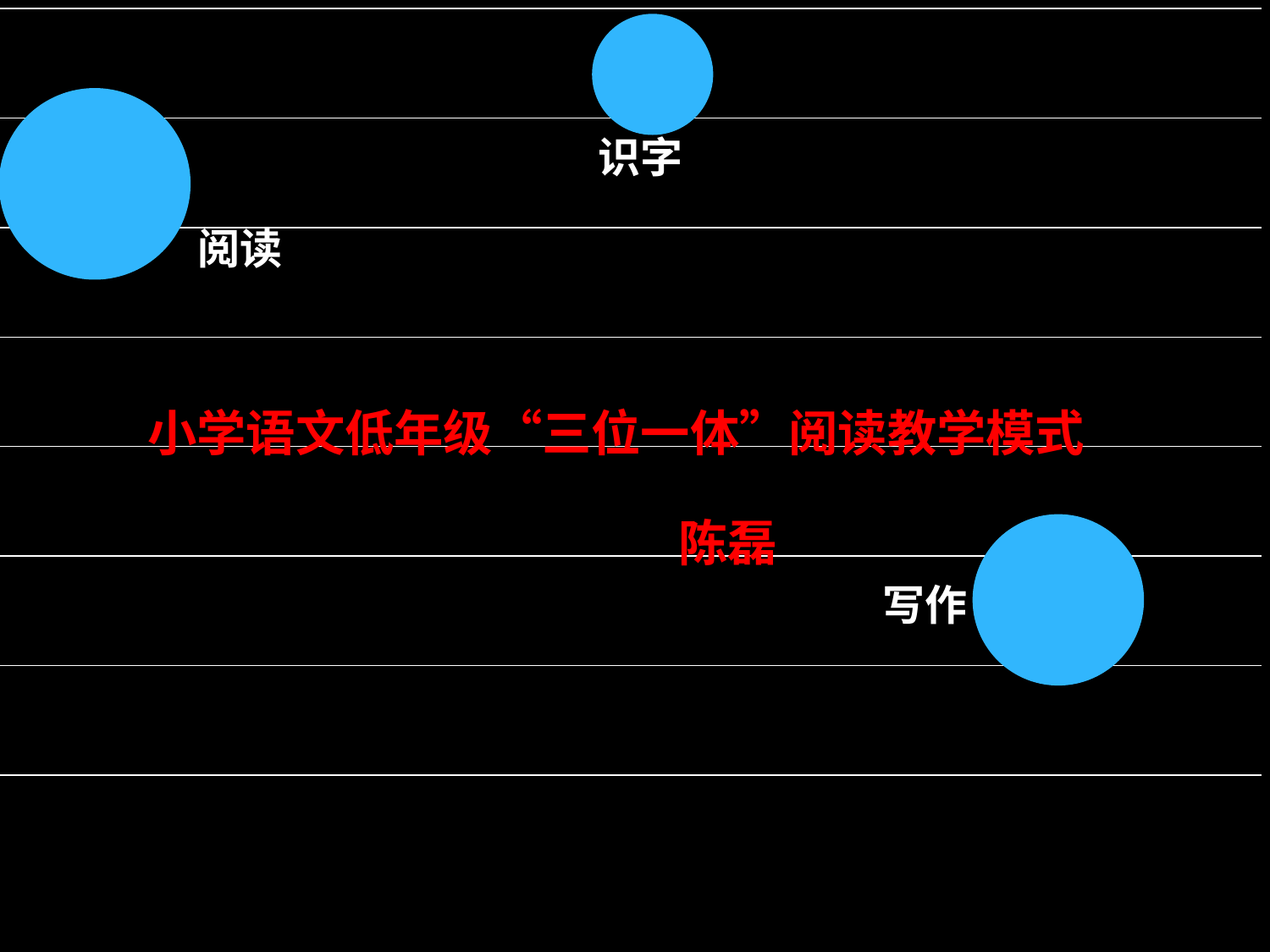
How many bubbles are plotted on the chart? 3 Which bubble is larger, 阅读 or 写作? 阅读 What colour are the bubbles on the chart? blue What are the labels of the three bubbles on the chart? 阅读, 识字, 写作 Which bubble is positioned furthest to the right on the chart? 写作 Which bubble on the chart is the smallest? 识字 Which bubble is positioned lowest on the chart? 写作 What kind of chart is shown on the slide? bubble chart Which bubble on the chart is the largest? 阅读